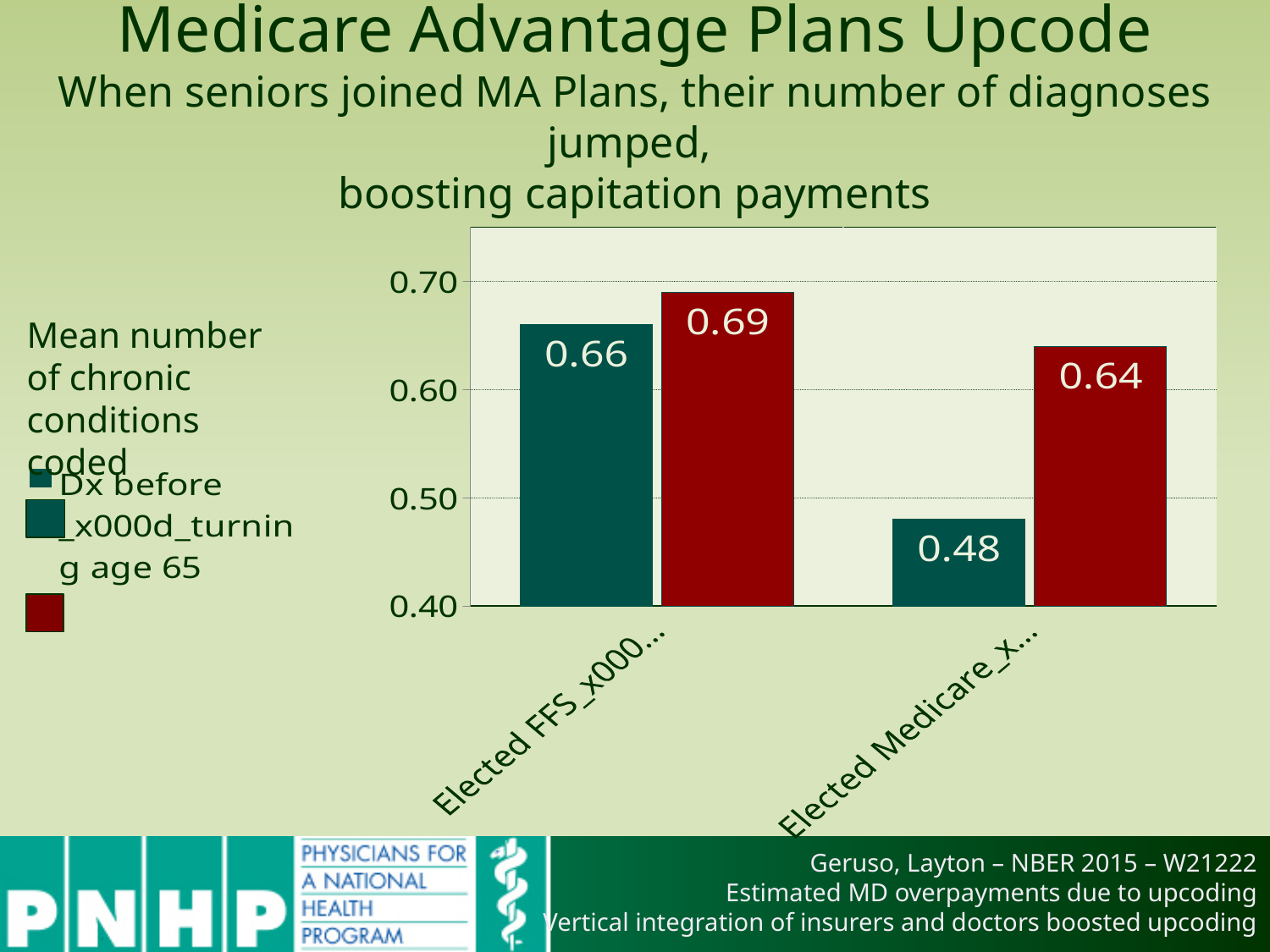
Is the dark teal bar in the 'Elected Medicare' group greater or less than 0.50? less What is the value of the dark teal bar in the 'Elected FFS' group? 0.66 What is the value of the dark red bar in the 'Elected Medicare' group? 0.64 What is the difference between the dark red and dark teal bars in the 'Elected Medicare' group? 0.16 Which bar has the lowest value in the chart? The dark teal bar in the 'Elected Medicare' group (0.48) What kind of chart is shown on the slide? bar chart What quantity does the chart measure, according to the label to the left of the chart? Mean number of chronic conditions coded What is the value of the dark teal bar in the 'Elected Medicare' group? 0.48 How many series does the chart's legend list? 2 How many category groups are shown on the x axis of the chart? 2 What is the value of the dark red bar in the 'Elected FFS' group? 0.69 Which bar has the highest value in the chart? The dark red bar in the 'Elected FFS' group (0.69)